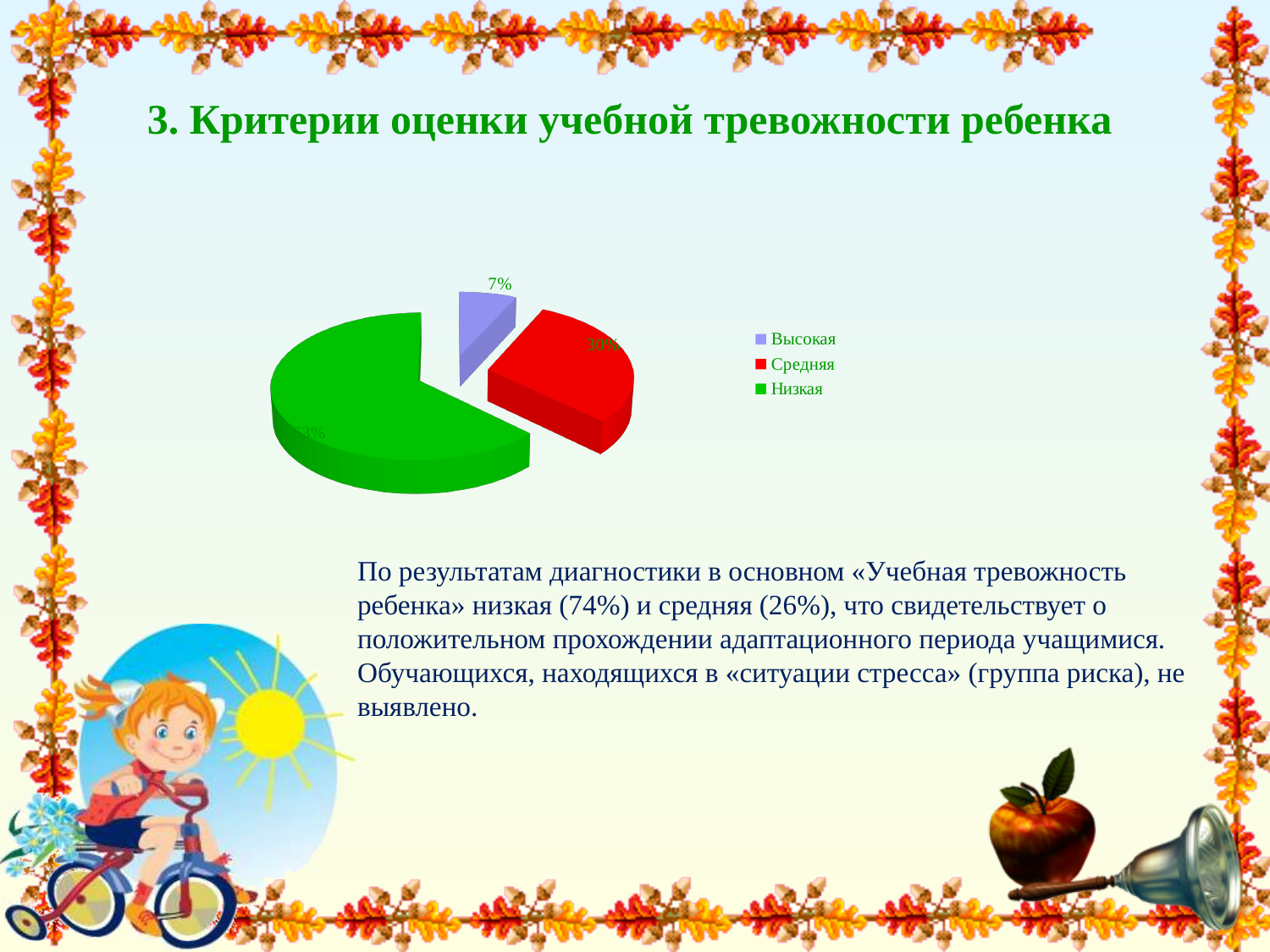
What are the three legend entries of the pie chart? Высокая, Средняя, Низкая What colour is the Низкая slice in the pie chart? green How many categories does the legend of the pie chart list? 3 What percentage is shown for the Высокая slice of the pie chart? 7% Which slice is larger in the pie chart, Низкая or Средняя? Низкая Which category has the largest slice in the pie chart? Низкая Which category has the smallest slice in the pie chart? Высокая What kind of chart is shown on the slide? pie chart What share of the pie does the Высокая slice represent? 7% Which slice is larger in the pie chart, Средняя or Высокая? Средняя